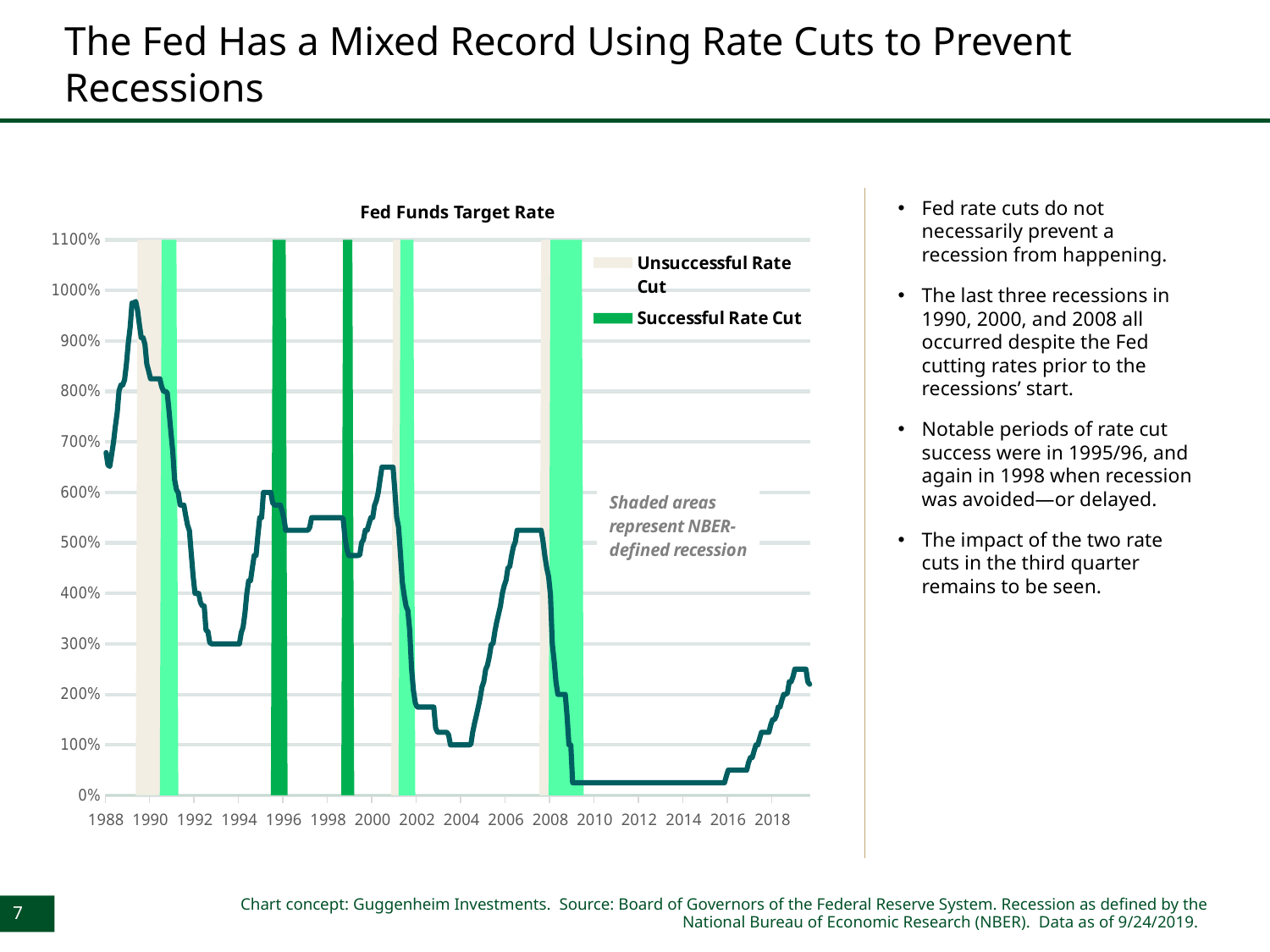
Which is higher: the peak of the Fed Funds Target Rate around 1989 or the peak around 2000? the peak around 1989 How many entries does the chart's legend list? 2 Is the Fed Funds Target Rate in 2012 greater or less than 100%? less Is the peak value of the Fed Funds Target Rate around 1989 greater or less than 900%? greater What is the highest value shown on the chart's y axis? 1100% What is the title of the chart? Fed Funds Target Rate What are the two entries in the chart's legend? Unsuccessful Rate Cut and Successful Rate Cut Is the peak value of the Fed Funds Target Rate around 2000 greater or less than 600%? greater Does the Fed Funds Target Rate rise or fall between 1989 and 1992? fall What kind of chart is shown on the slide? line chart Does the Fed Funds Target Rate rise or fall between 2004 and 2006? rise